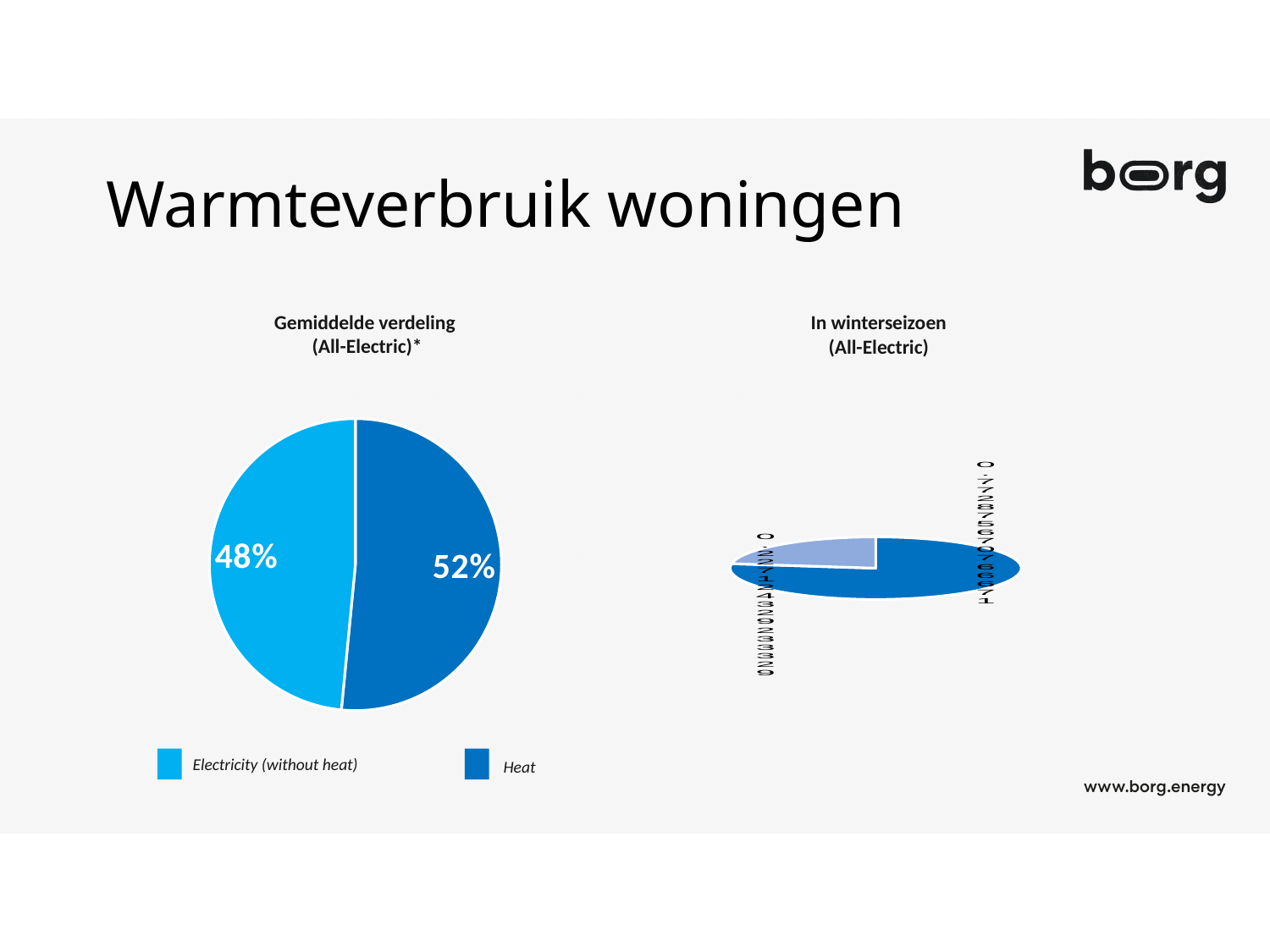
What is the title of the chart on the right side of the slide? In winterseizoen (All-Electric) In the 'Gemiddelde verdeling (All-Electric)*' pie chart, which is larger: Heat or Electricity (without heat)? Heat In the 'Gemiddelde verdeling (All-Electric)*' pie chart, is the share for Heat greater or less than 50%? greater In the 'Gemiddelde verdeling (All-Electric)*' pie chart, what do the two slices add up to? 100% In the 'Gemiddelde verdeling (All-Electric)*' pie chart, which category has the largest slice? Heat How many slices does the 'Gemiddelde verdeling (All-Electric)*' pie chart have? 2 In the 'Gemiddelde verdeling (All-Electric)*' pie chart, by how many percentage points does Heat exceed Electricity (without heat)? 4 percentage points In the 'Gemiddelde verdeling (All-Electric)*' pie chart, what share is shown for Heat? 52% What kind of chart is the 'Gemiddelde verdeling (All-Electric)*' chart on the left? Pie chart In the 'Gemiddelde verdeling (All-Electric)*' pie chart, which category has the smallest slice? Electricity (without heat) What are the two legend entries shown below the left pie chart? Electricity (without heat) and Heat In the 'Gemiddelde verdeling (All-Electric)*' pie chart, what share is shown for Electricity (without heat)? 48%